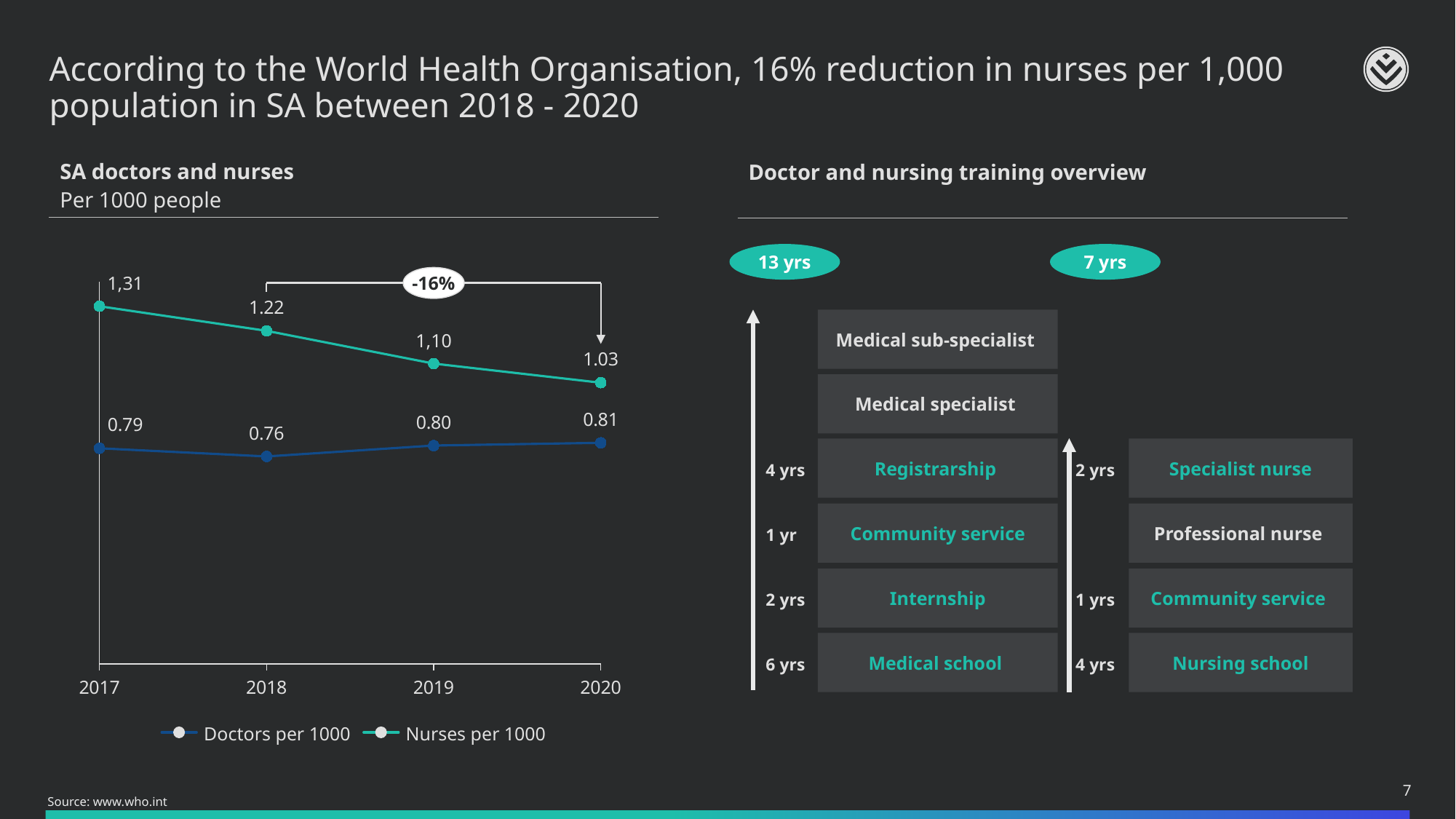
What type of chart is 'SA doctors and nurses'? line chart In the 'SA doctors and nurses' chart, does the Nurses per 1000 series rise or fall from 2017 to 2020? fall In the 'SA doctors and nurses' chart, what is the value of Nurses per 1000 in 2017? 1,31 In the 'SA doctors and nurses' chart, what is the value of Nurses per 1000 in 2020? 1.03 In the 'SA doctors and nurses' chart, which is larger in 2019: Doctors per 1000 or Nurses per 1000? Nurses per 1000 In the 'SA doctors and nurses' chart, what is the value of Doctors per 1000 in 2020? 0.81 In the 'SA doctors and nurses' chart, which year has the highest value for Nurses per 1000? 2017 How many years are plotted on the x axis of the 'SA doctors and nurses' chart? 4 In the 'SA doctors and nurses' chart, what is the difference between Nurses per 1000 in 2018 and in 2020? 0.19 How many series does the legend of the 'SA doctors and nurses' chart list? 2 In the 'SA doctors and nurses' chart, what is the value of Doctors per 1000 in 2018? 0.76 In the 'SA doctors and nurses' chart, which year has the lowest value for Doctors per 1000? 2018